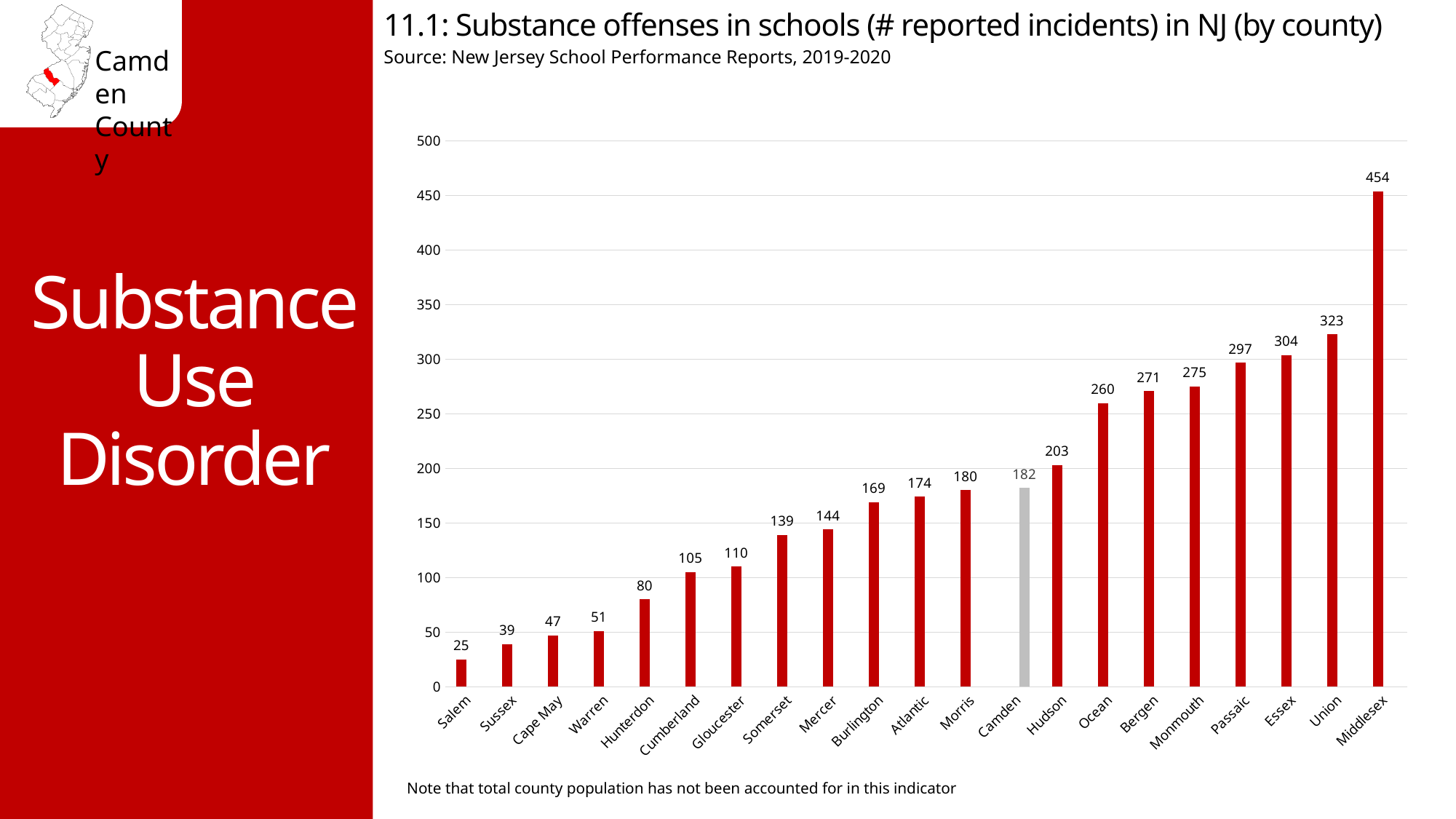
How many counties are shown on the x axis of the chart? 21 Is the value for Passaic greater or less than 250? greater What is the difference between the values for Middlesex and Union? 131 What is the value shown for Hunterdon county? 80 Which county has the highest number of reported incidents? Middlesex What is the number of reported substance offense incidents in schools for Camden county? 182 What kind of chart is shown on the slide? Bar chart Which county has a larger value, Hudson or Camden? Hudson What is the difference between the values for Camden and Salem? 157 Which county's bar is coloured grey instead of red? Camden Which county has the lowest number of reported incidents? Salem What is the value shown for Middlesex county? 454